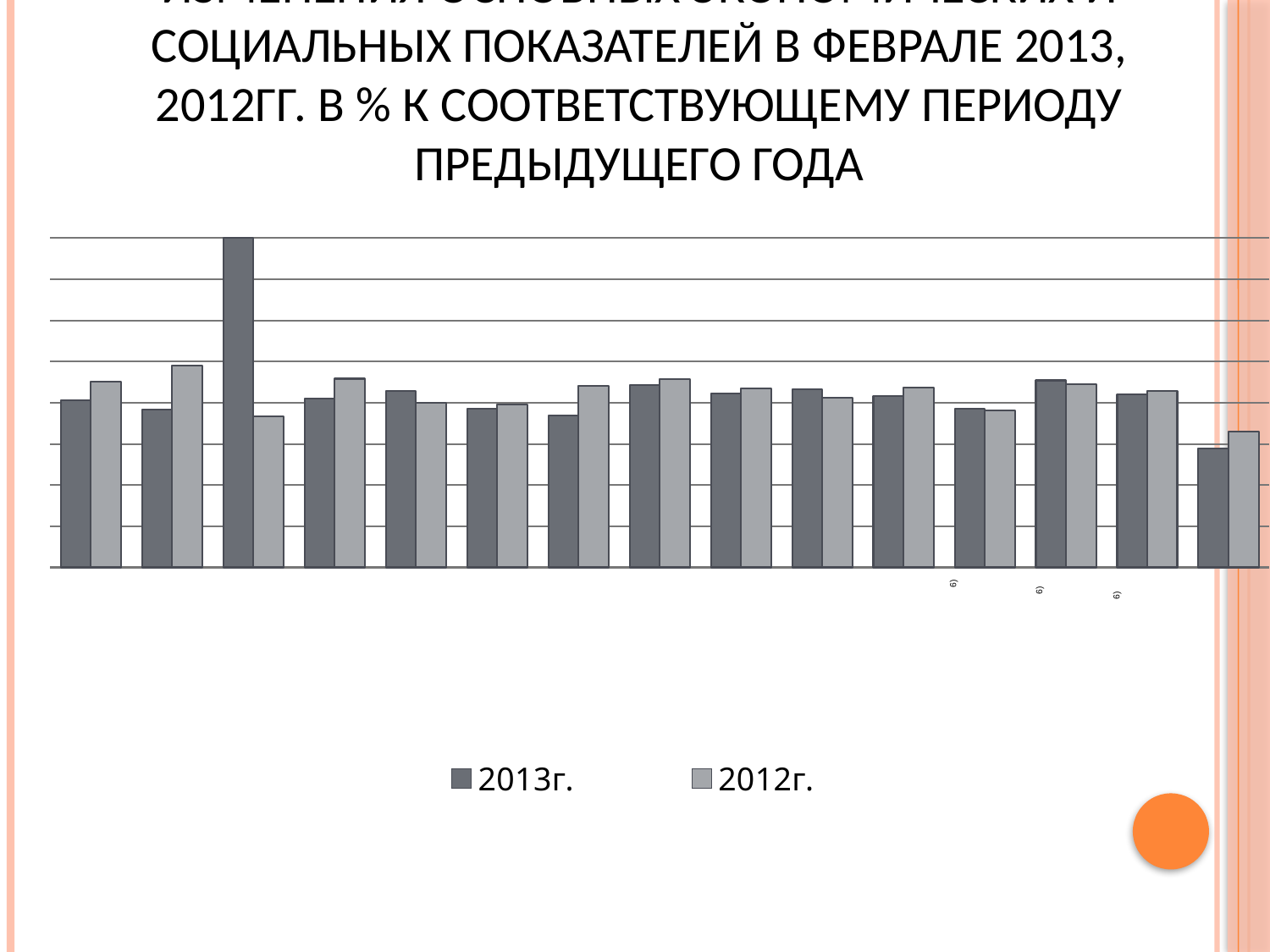
Which series does the single tallest bar on the chart belong to? 2013г. What are the two series named in the legend? 2013г. and 2012г. How many series does the legend list? 2 How many groups of bars are plotted along the x axis? 15 What kind of chart is shown on the slide? bar chart Which series is drawn in the darker grey bars? 2013г.